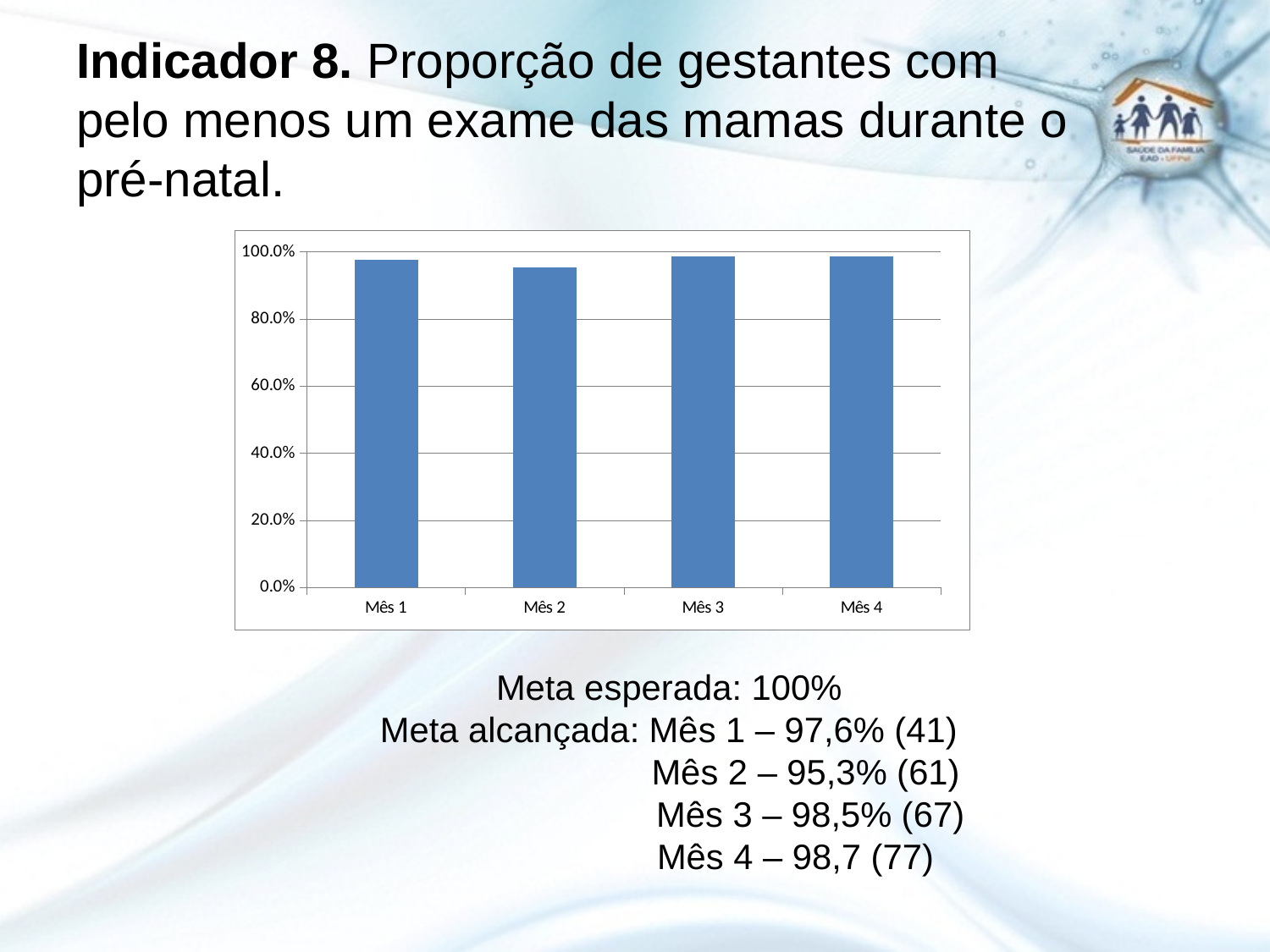
According to the slide, what proportion was achieved in Mês 1? 97,6% Which is larger, the value for Mês 3 or the value for Mês 2? Mês 3 Which is larger, the value for Mês 1 or the value for Mês 2? Mês 1 Which month has the lowest value in the chart? Mês 2 According to the slide, what proportion was achieved in Mês 3? 98,5% What is the difference in percentage points between the values for Mês 3 and Mês 2 as printed on the slide? 3,2 How many months (categories) are plotted in the chart? 4 According to the slide, what proportion was achieved in Mês 2? 95,3% What is the expected target (meta esperada) stated on the slide? 100% What kind of chart is shown on the slide? Bar chart Is the value for Mês 2 greater or less than 80.0%? greater Is the value for Mês 1 greater or less than 100.0%? less